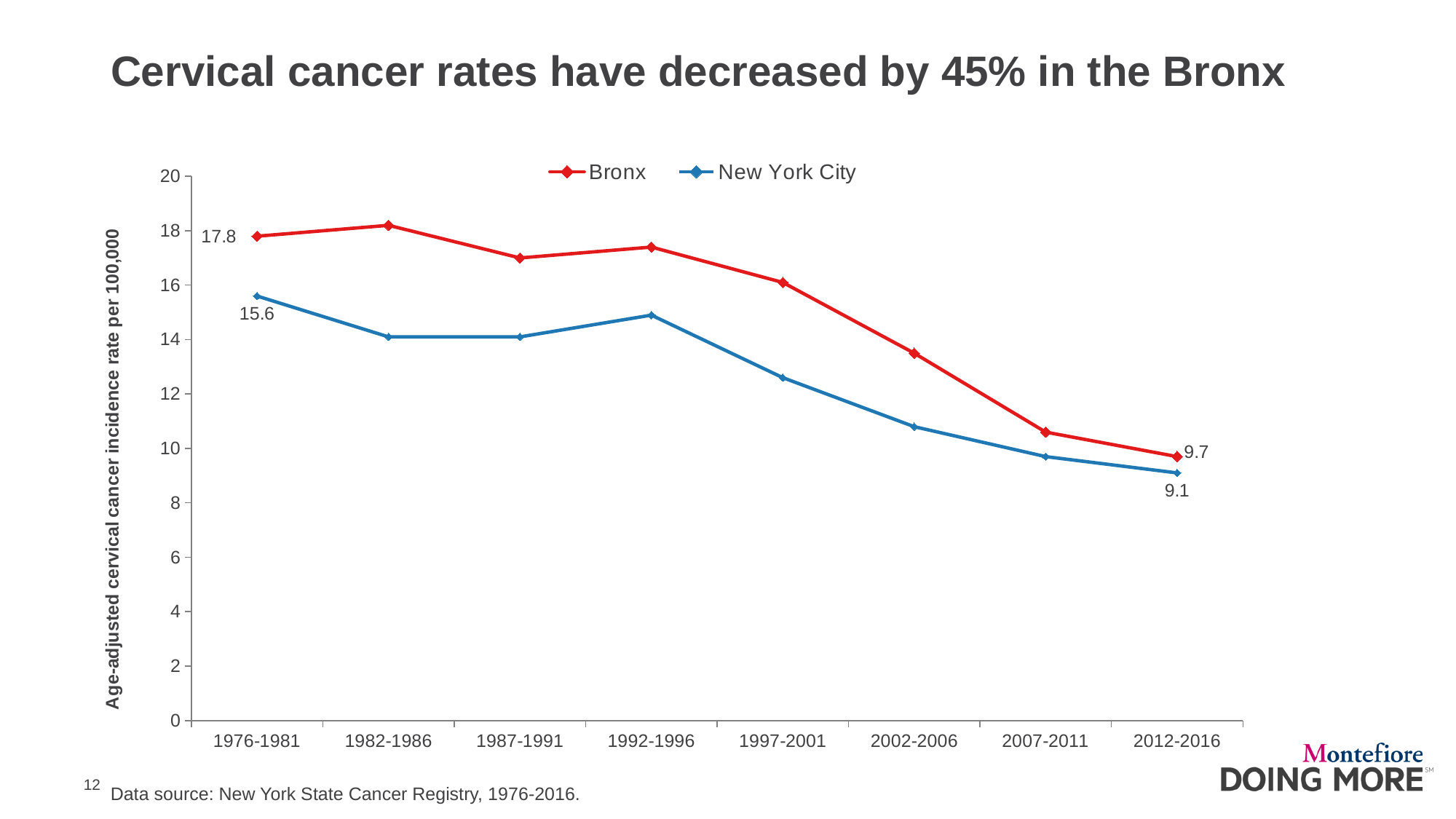
How many time periods are shown on the x axis? 8 Which series has the higher value in 1976-1981, Bronx or New York City? Bronx What kind of chart is shown on the slide? Line chart What is the New York City cervical cancer incidence rate for 2012-2016? 9.1 By how much did the Bronx rate fall from 1976-1981 to 2012-2016? 8.1 What is the Bronx cervical cancer incidence rate for 1976-1981? 17.8 What is the New York City cervical cancer incidence rate for 1976-1981? 15.6 What is the difference between the Bronx and New York City rates in 1976-1981? 2.2 What is the Bronx cervical cancer incidence rate for 2012-2016? 9.7 Is the Bronx value for 1997-2001 greater or less than 14? greater Is the New York City value for 2002-2006 greater or less than 12? less How many series does the legend list? 2